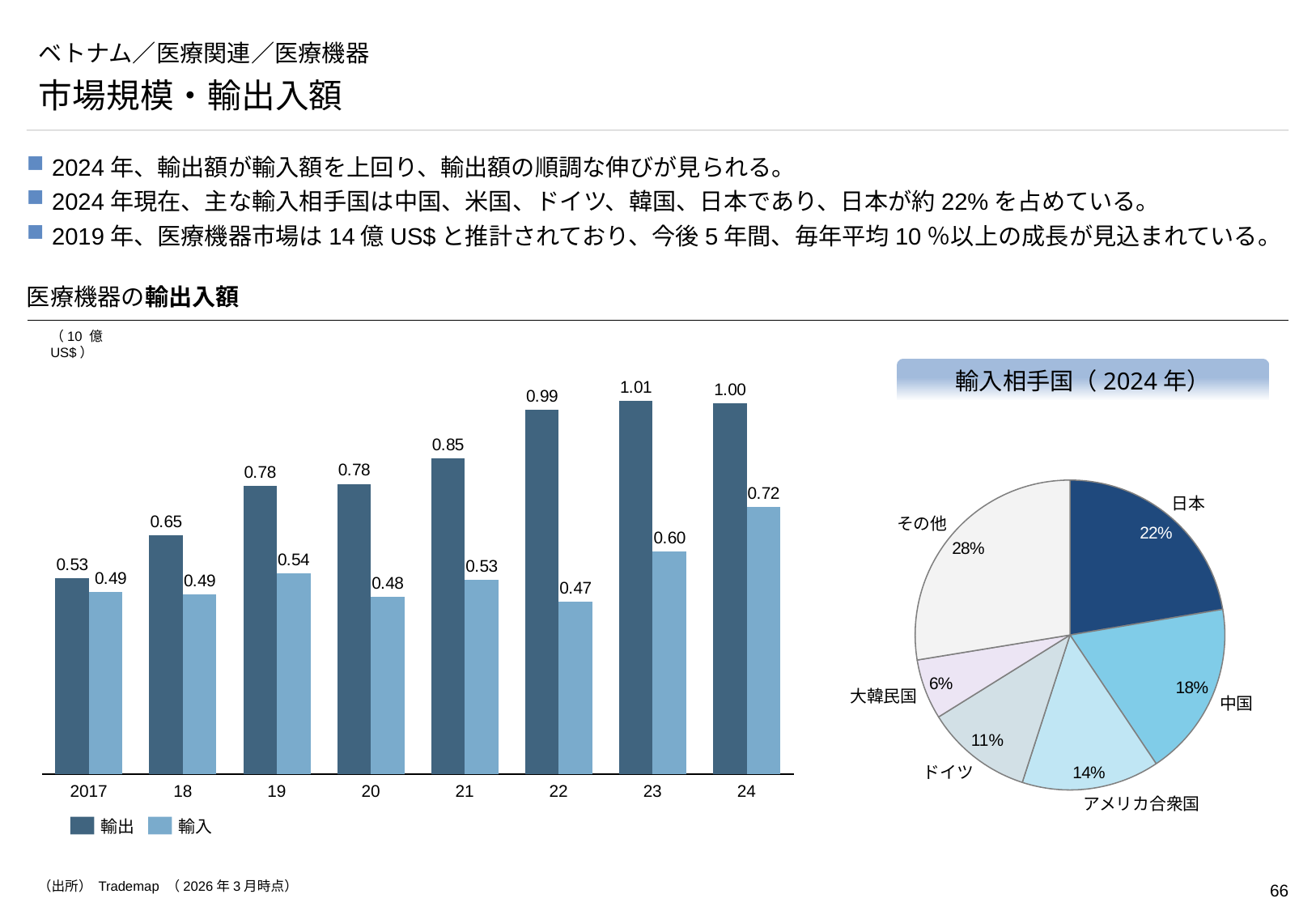
In the bar chart of medical device exports and imports, what is the export (輸出) value for 2024? 1.00 In the bar chart of medical device exports and imports, which is larger in 2017, the export (輸出) value or the import (輸入) value? 輸出 In the pie chart of import partner countries (2024), how many slices are there? 6 In the bar chart of medical device exports and imports, which year has the lowest import (輸入) value? 2022 In the bar chart of medical device exports and imports, how many years are shown on the x axis? 8 In the bar chart of medical device exports and imports, which year has the highest export (輸出) value? 2023 In the pie chart of import partner countries (2024), which named country has the smallest share? 大韓民国 In the bar chart of medical device exports and imports, what is the difference between the export and import values in 2022? 0.52 In the bar chart of medical device exports and imports, what is the import (輸入) value for 2019? 0.54 In the pie chart of import partner countries (2024), what share does 日本 (Japan) hold? 22% What kind of chart is the chart on the left of the slide? Bar chart In the bar chart of medical device exports and imports, how many series does the legend list? 2